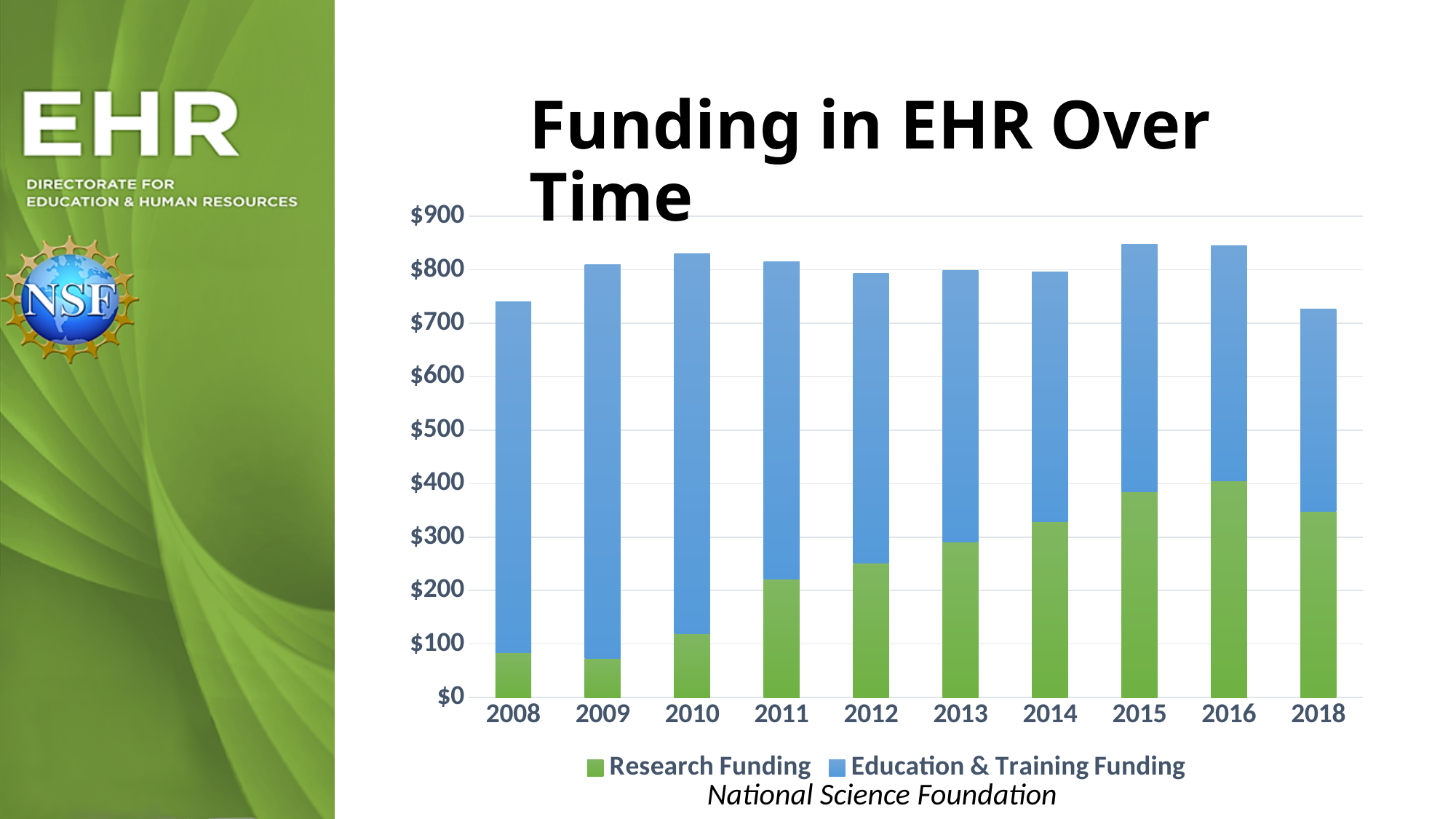
Is the total funding for 2018 greater or less than $800? less Which series is shown in green? Research Funding What is the title of the chart? Funding in EHR Over Time Is Research Funding larger in 2016 or in 2008? 2016 What kind of chart is shown on the slide? Stacked bar chart Is the total funding for 2008 greater or less than $700? greater Is the Research Funding value for 2014 greater or less than $300? greater How many series does the chart's legend list? 2 Which year has the highest Research Funding? 2016 How many years are shown on the x axis of the chart? 10